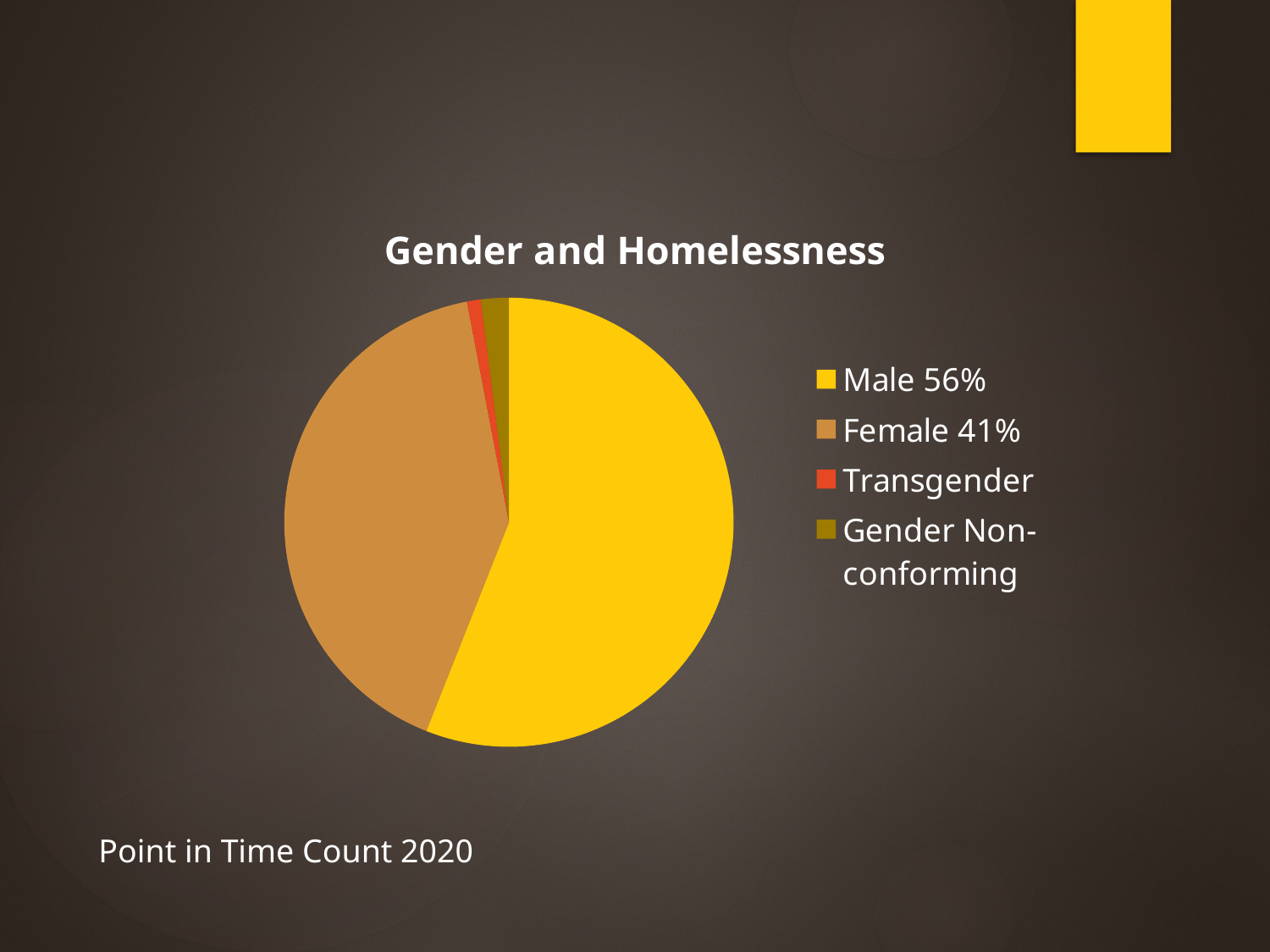
What share of the pie does the Male slice represent? 56% How many categories does the pie chart show? 4 What percentage of the pie is Male? 56% Which category is shown in yellow in the pie chart? Male Which is larger, the Male slice or the Female slice? Male What is the difference between the Male and Female percentages? 15% What kind of chart is shown on the slide? pie chart What is the title of the chart? Gender and Homelessness Is the Female slice larger or smaller than the Transgender slice? larger Which category has the largest slice of the pie? Male What percentage of the pie is Female? 41%